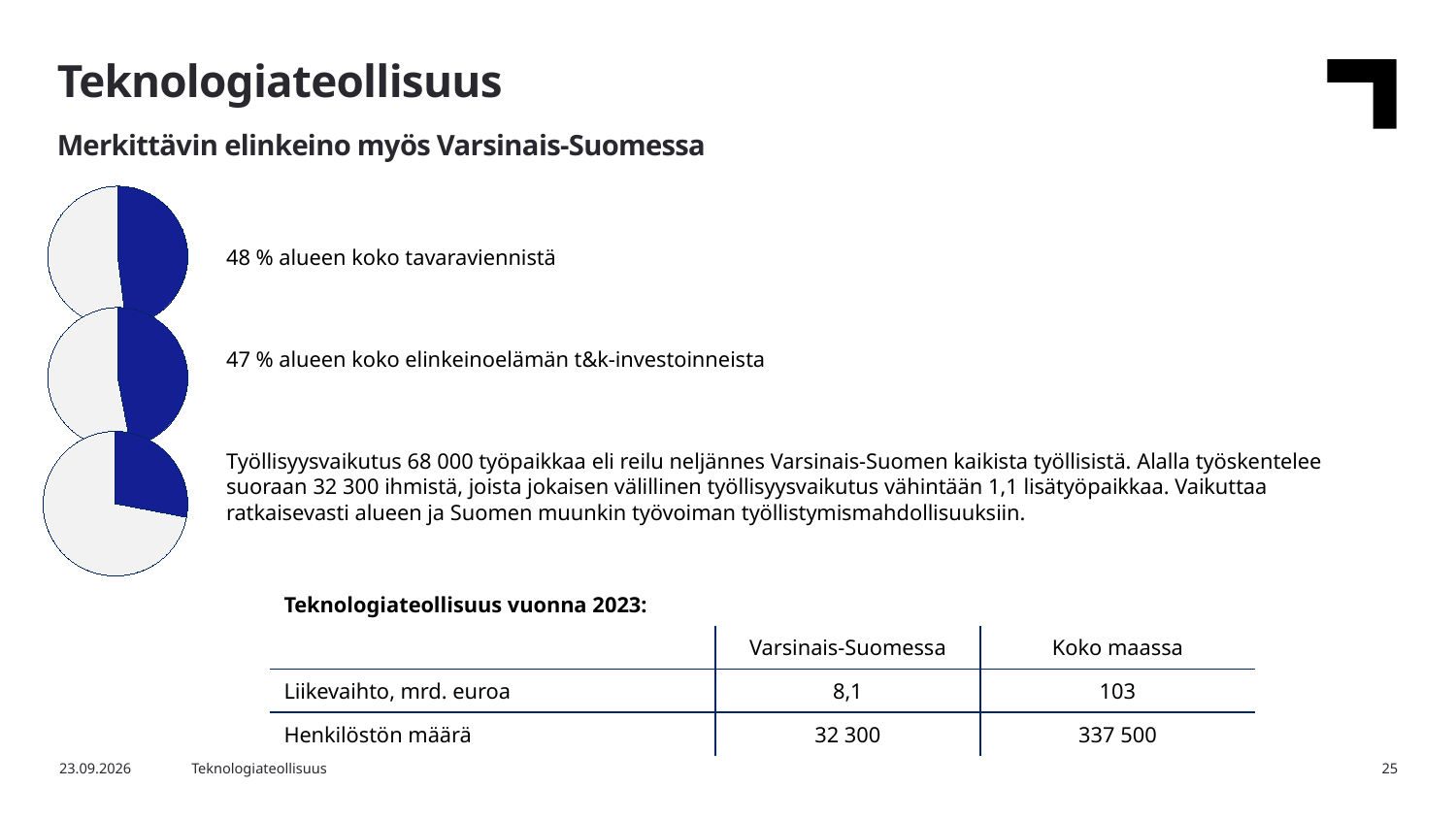
What colour is the highlighted slice in each pie chart? Blue What kind of charts are shown on the left side of the slide? Pie charts According to the text next to the middle pie chart, what share of the region's business R&D investments (t&k-investoinnit) does the highlighted slice represent? 47 % How many pie charts are on the slide? 3 Is the highlighted slice in the top pie chart greater or less than a quarter of the pie? Greater Is the highlighted slice in the bottom pie chart larger or smaller than the highlighted slice in the top pie chart? Smaller What does the top pie chart illustrate, according to the text beside it? 48 % alueen koko tavaraviennistä Is the highlighted slice in the bottom pie chart greater or less than half of the pie? Less Which of the three pie charts has the smallest highlighted slice? The bottom pie chart According to the text next to the top pie chart, what share of the region's total goods exports (tavaravienti) does the highlighted slice represent? 48 %